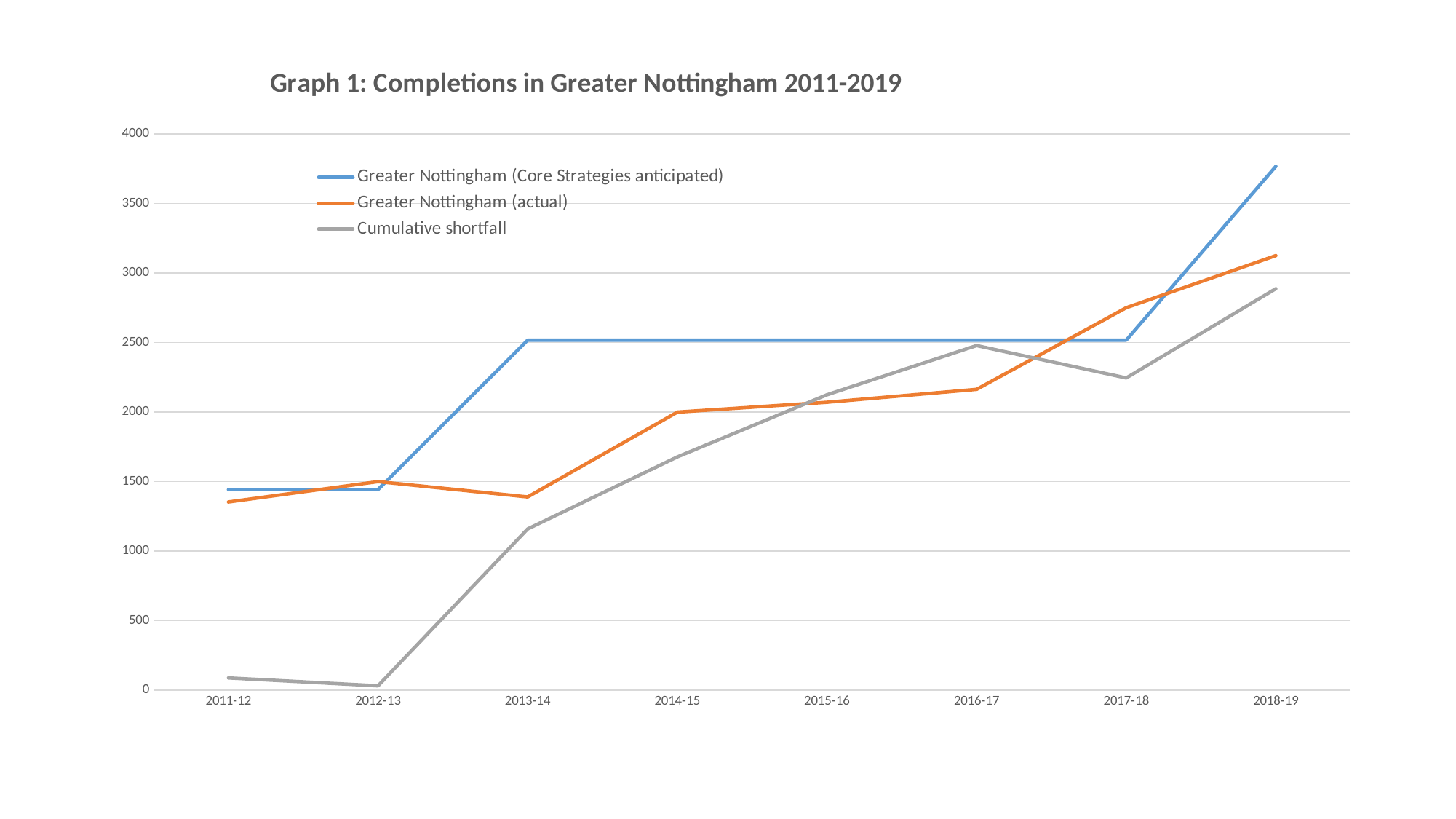
In which year is the Cumulative shortfall highest? 2018-19 Does the Greater Nottingham (Core Strategies anticipated) line rise, fall or stay flat between 2013-14 and 2017-18? stay flat What kind of chart is shown on the slide? line chart Is the value for Cumulative shortfall in 2013-14 greater or less than 1000? greater In which year is the Cumulative shortfall lowest? 2012-13 Is the value for Greater Nottingham (actual) in 2014-15 greater or less than 2500? less Is the value for Greater Nottingham (Core Strategies anticipated) in 2018-19 greater or less than 3500? greater In 2017-18, which is higher: Greater Nottingham (actual) or Greater Nottingham (Core Strategies anticipated)? Greater Nottingham (actual) How many series does the legend list? 3 What colour is the Cumulative shortfall line? grey How many years are plotted along the x axis? 8